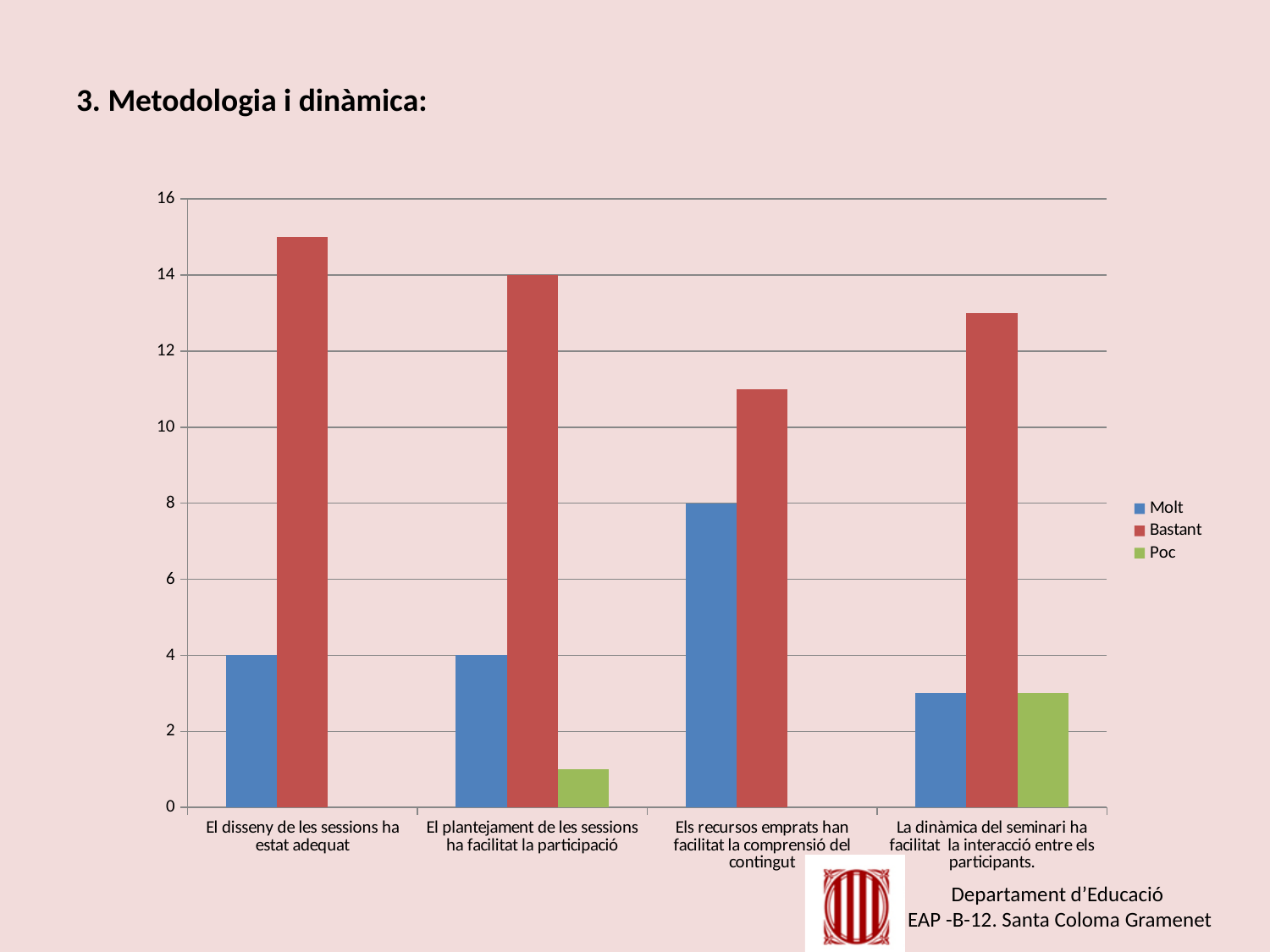
What is the value of Molt for 'Els recursos emprats han facilitat la comprensió del contingut'? 8 What type of chart is shown on the slide? bar chart Is the Bastant value for 'Els recursos emprats han facilitat la comprensió del contingut' greater or less than 12? less What is the value of Molt for 'El disseny de les sessions ha estat adequat'? 4 Is the Bastant value for 'El disseny de les sessions ha estat adequat' greater or less than 14? greater What is the value of Bastant for 'El plantejament de les sessions ha facilitat la participació'? 14 Which series is shown in green in the legend? Poc Which category has the highest Bastant value? El disseny de les sessions ha estat adequat Which is larger for 'La dinàmica del seminari ha facilitat la interacció entre els participants': Molt or Bastant? Bastant How many series does the legend list? 3 Which category has the highest Molt value? Els recursos emprats han facilitat la comprensió del contingut How many categories are shown on the x axis? 4